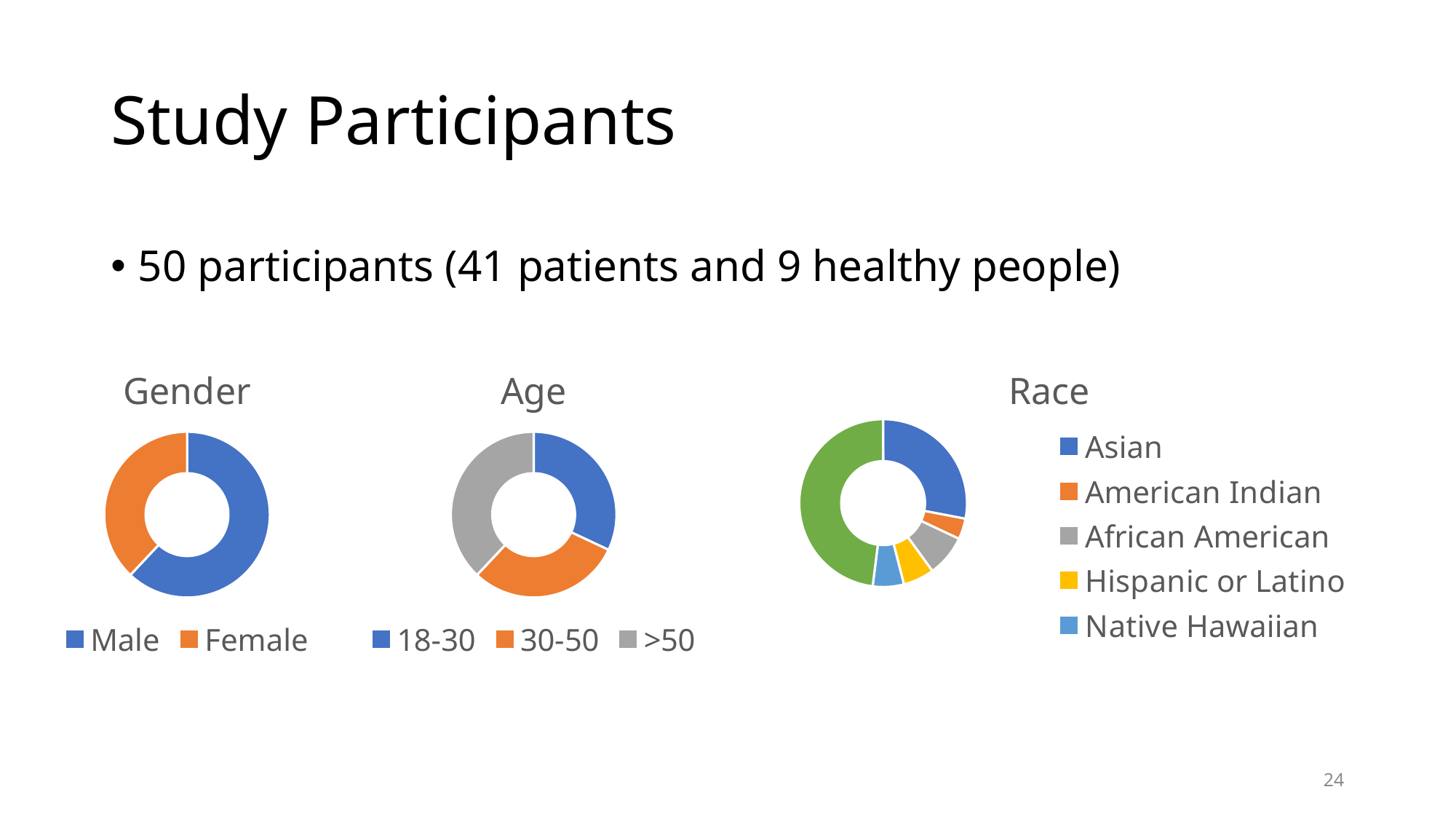
What colour represents Hispanic or Latino in the Race chart? yellow What are the three age groups shown in the Age chart's legend? 18-30, 30-50, >50 How many categories does the Age chart's legend list? 3 In the Race chart, which is larger, Asian or Hispanic or Latino? Asian How many categories does the Gender chart's legend list? 2 In the Gender chart, which category is the largest? Male In the Gender chart, which is larger, Male or Female? Male What kind of chart is the Gender chart? doughnut chart How many entries does the Race chart's legend list? 5 In the Race chart, which is larger, Asian or African American? Asian What kind of chart is the Race chart? doughnut chart In the Gender chart, which category is the smallest? Female